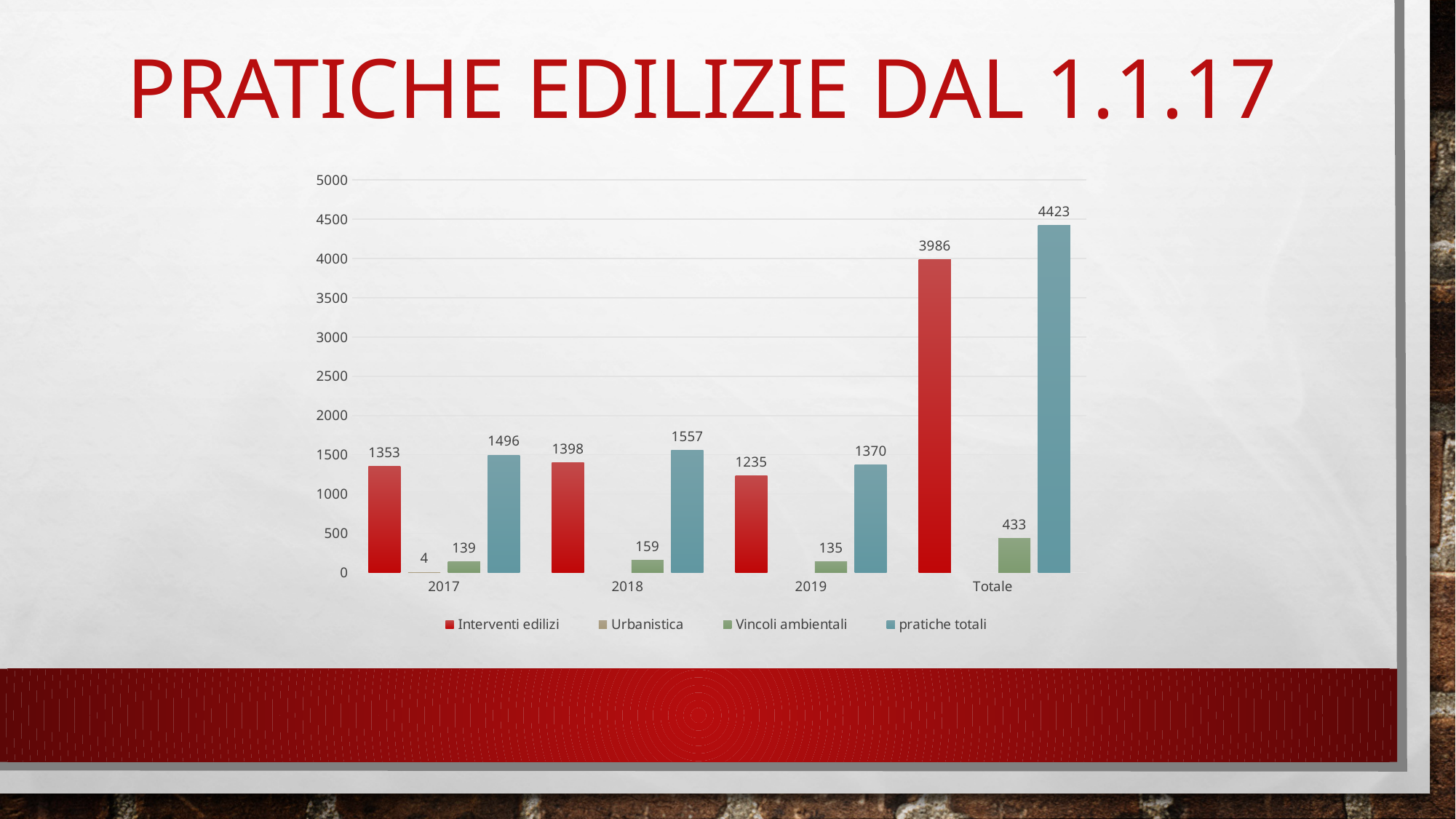
What is the value of pratiche totali for 2018? 1557 What is the value of Interventi edilizi for 2017? 1353 What kind of chart is shown on the slide? bar chart Is the value of Interventi edilizi for Totale greater or less than 3500? greater How many categories are shown on the x axis? 4 What is the value of Vincoli ambientali for 2019? 135 How many series does the legend list? 4 Which year (2017, 2018 or 2019) has the lowest value for pratiche totali? 2019 Which year (2017, 2018 or 2019) has the highest value for Interventi edilizi? 2018 Which is larger: Vincoli ambientali for 2018 or Vincoli ambientali for 2017? Vincoli ambientali for 2018 What is the value of Urbanistica for 2017? 4 What is the difference between pratiche totali and Interventi edilizi for Totale? 437